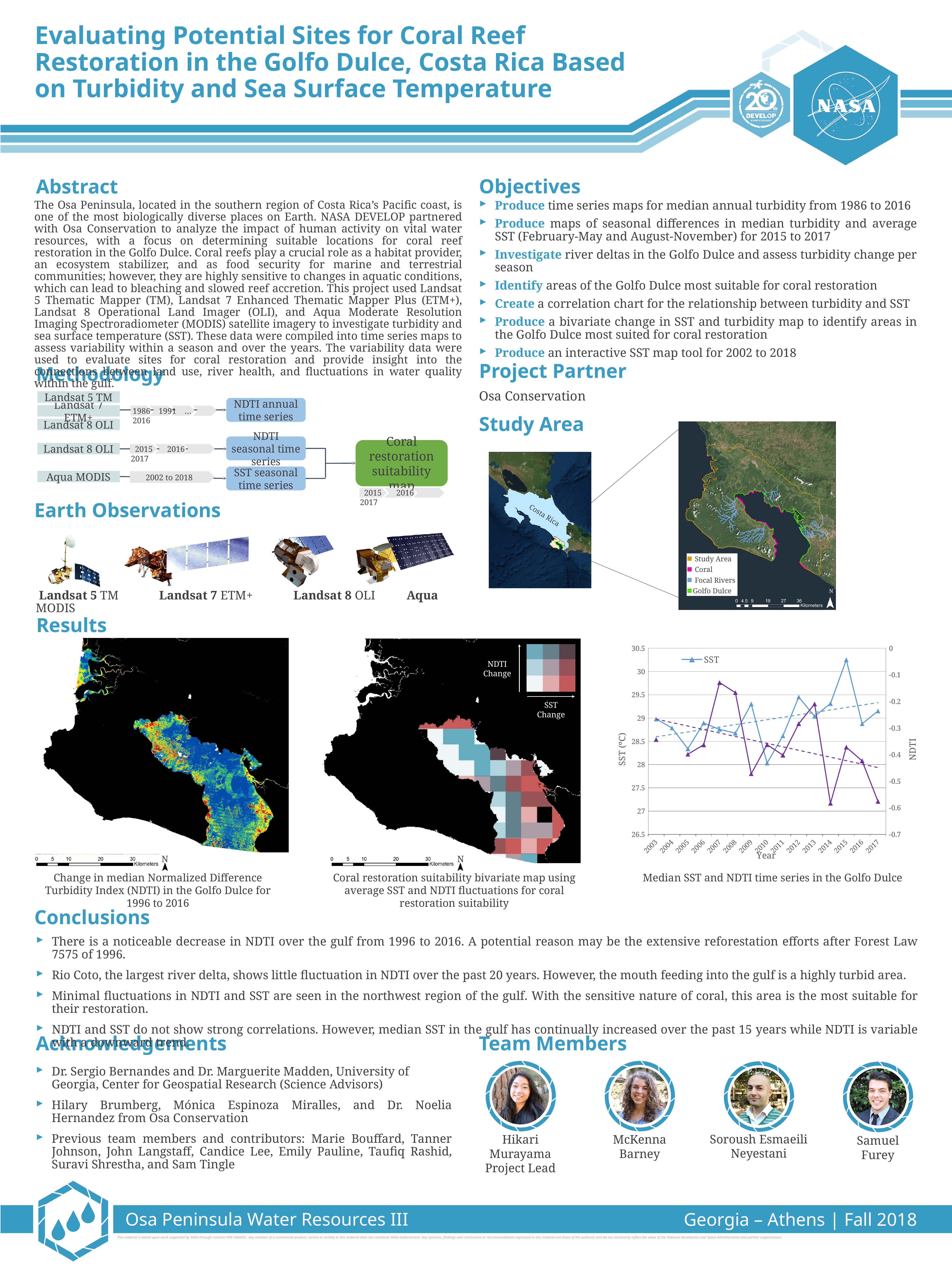
In the 'Median SST and NDTI time series in the Golfo Dulce' chart, does the dashed SST trend line rise or fall from 2003 to 2017? rise In the 'Median SST and NDTI time series in the Golfo Dulce' chart, which year has the highest SST value? 2015 In the 'Median SST and NDTI time series in the Golfo Dulce' chart, is the SST value for 2005 greater or less than 29? less What kind of chart is 'Median SST and NDTI time series in the Golfo Dulce'? line chart In the 'Median SST and NDTI time series in the Golfo Dulce' chart, what series name is shown in the legend? SST In the 'Median SST and NDTI time series in the Golfo Dulce' chart, which year has the lowest SST value? 2010 In the 'Median SST and NDTI time series in the Golfo Dulce' chart, is the SST value for 2015 greater or less than 30? greater In the 'Median SST and NDTI time series in the Golfo Dulce' chart, how many years are plotted along the x axis? 15 In the 'Median SST and NDTI time series in the Golfo Dulce' chart, which year has the larger SST value, 2012 or 2010? 2012 In the 'Median SST and NDTI time series in the Golfo Dulce' chart, does the dashed NDTI trend line rise or fall from 2003 to 2017? fall In the 'Median SST and NDTI time series in the Golfo Dulce' chart, what is the label of the left vertical axis? SST (°C) In the 'Median SST and NDTI time series in the Golfo Dulce' chart, is the SST value for 2012 greater or less than 29? greater